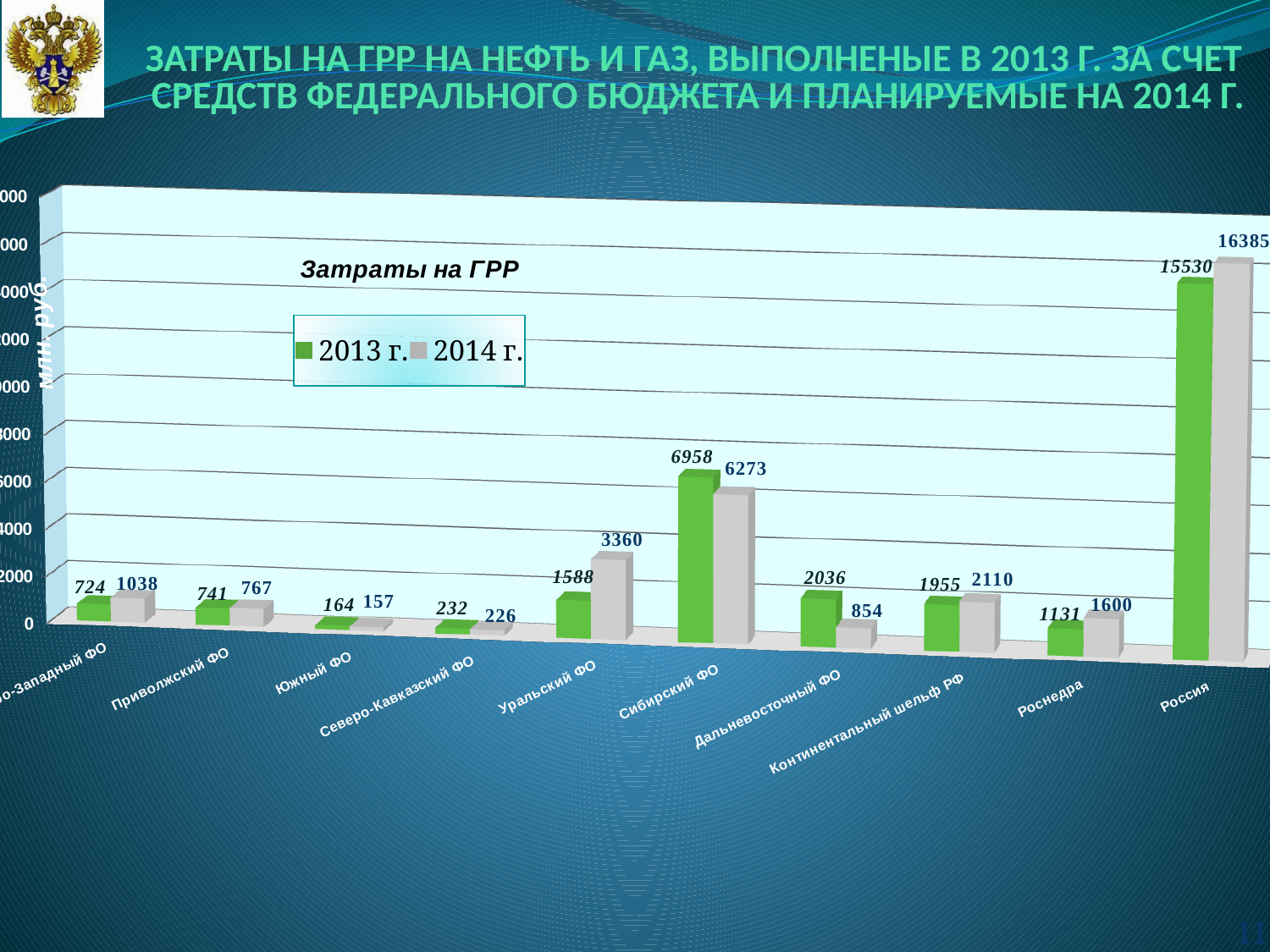
What is the difference between the 2014 г. and 2013 г. values for Россия? 855 Which category has the lowest value in the 2013 г. series? Южный ФО What is the title of the chart? Затраты на ГРР How many series does the legend list? 2 What is the difference between the 2013 г. and 2014 г. values for Дальневосточный ФО? 1182 What is the value for Уральский ФО in the 2014 г. series? 3360 Which category has the highest value in the 2014 г. series? Россия For Сибирский ФО, which series has the larger value, 2013 г. or 2014 г.? 2013 г. What is the 2013 г. value for Роснедра? 1131 What kind of chart is shown on the slide? Bar chart What is the 2014 г. value for Дальневосточный ФО? 854 What is the value for Сибирский ФО in the 2013 г. series? 6958